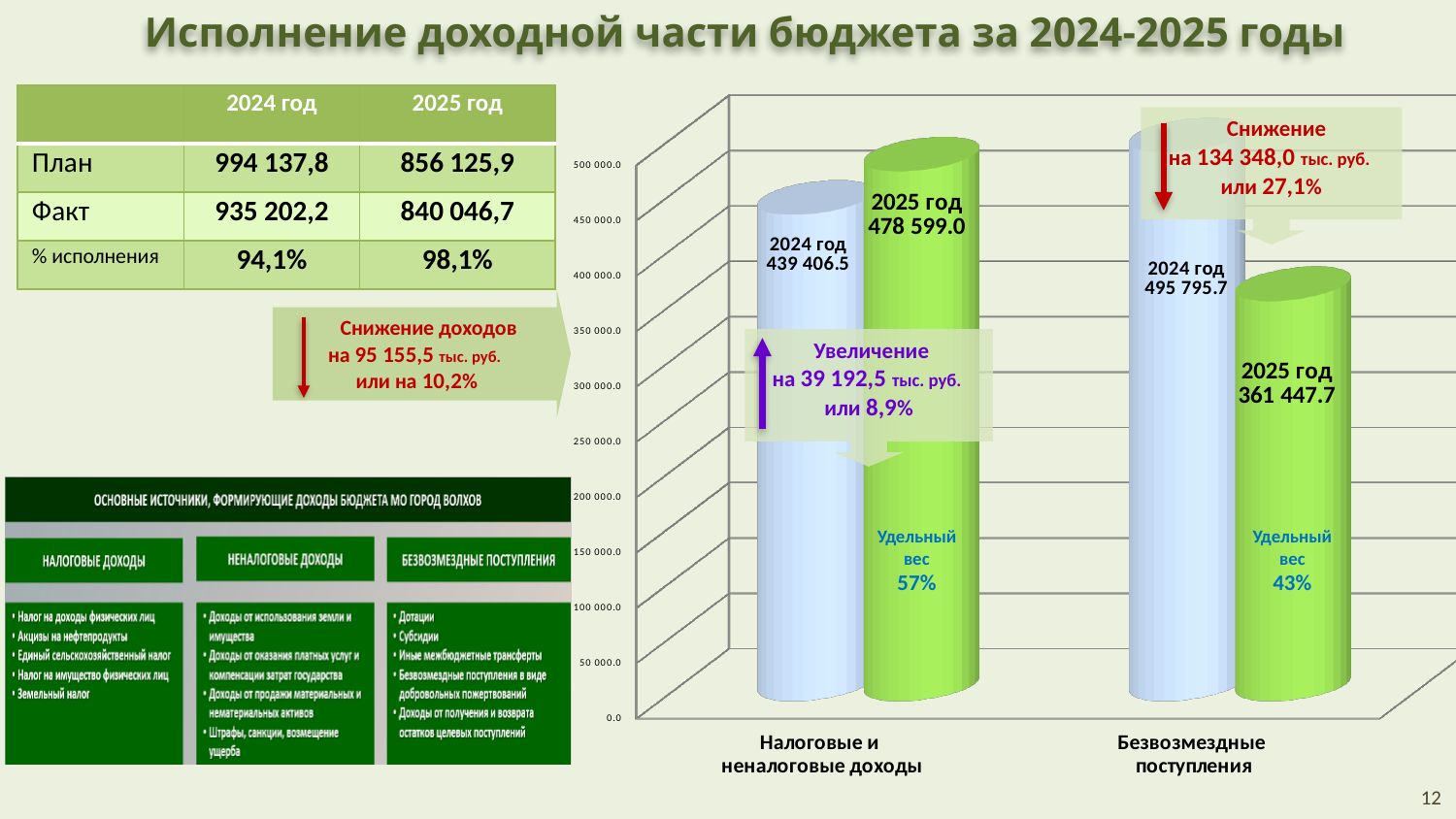
What is the value for 2025 год in the category Безвозмездные поступления? 361 447.7 Which bar in the chart has the highest value? 2024 год, Безвозмездные поступления Is the value for 2025 год in the category Безвозмездные поступления greater or less than 400 000.0? less What is the difference between the 2025 год and 2024 год values in the category Налоговые и неналоговые доходы? 39 192.5 What share (Удельный вес) is shown for the category Налоговые и неналоговые доходы? 57% How many categories are shown on the x axis of the chart? 2 What type of chart is shown on the right side of the slide? bar chart What is the value for 2024 год in the category Налоговые и неналоговые доходы? 439 406.5 What is the value for 2025 год in the category Налоговые и неналоговые доходы? 478 599.0 What is the value for 2024 год in the category Безвозмездные поступления? 495 795.7 In the category Безвозмездные поступления, which year has the larger value, 2024 год or 2025 год? 2024 год Which bar in the chart has the lowest value? 2025 год, Безвозмездные поступления